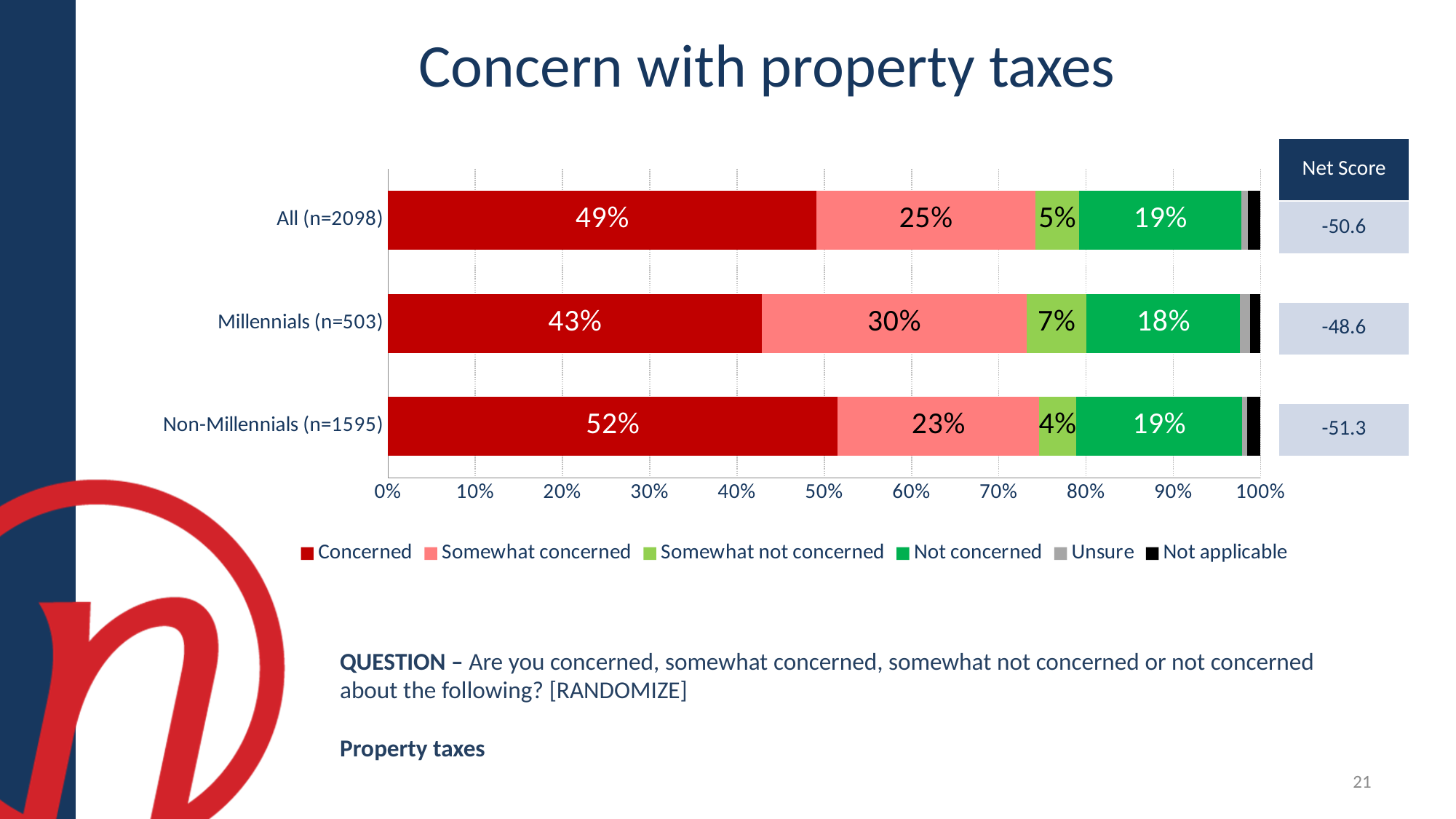
How many groups are shown on the chart? 3 How many series does the legend list? 6 What percentage of Millennials (n=503) are Somewhat concerned? 30% What kind of chart is shown on the slide? Stacked bar chart What percentage of All (n=2098) respondents are Concerned about property taxes? 49% What is the difference between the Concerned percentages for Non-Millennials (n=1595) and Millennials (n=503)? 9% What percentage of Non-Millennials (n=1595) are Not concerned? 19% Which group has the lowest Somewhat not concerned percentage? Non-Millennials (n=1595) Which group has the highest Concerned percentage? Non-Millennials (n=1595) What is the title of the chart? Concern with property taxes What is the Net Score for Millennials (n=503)? -48.6 Which is larger: the Somewhat concerned share for Millennials (n=503) or for All (n=2098)? Millennials (n=503)